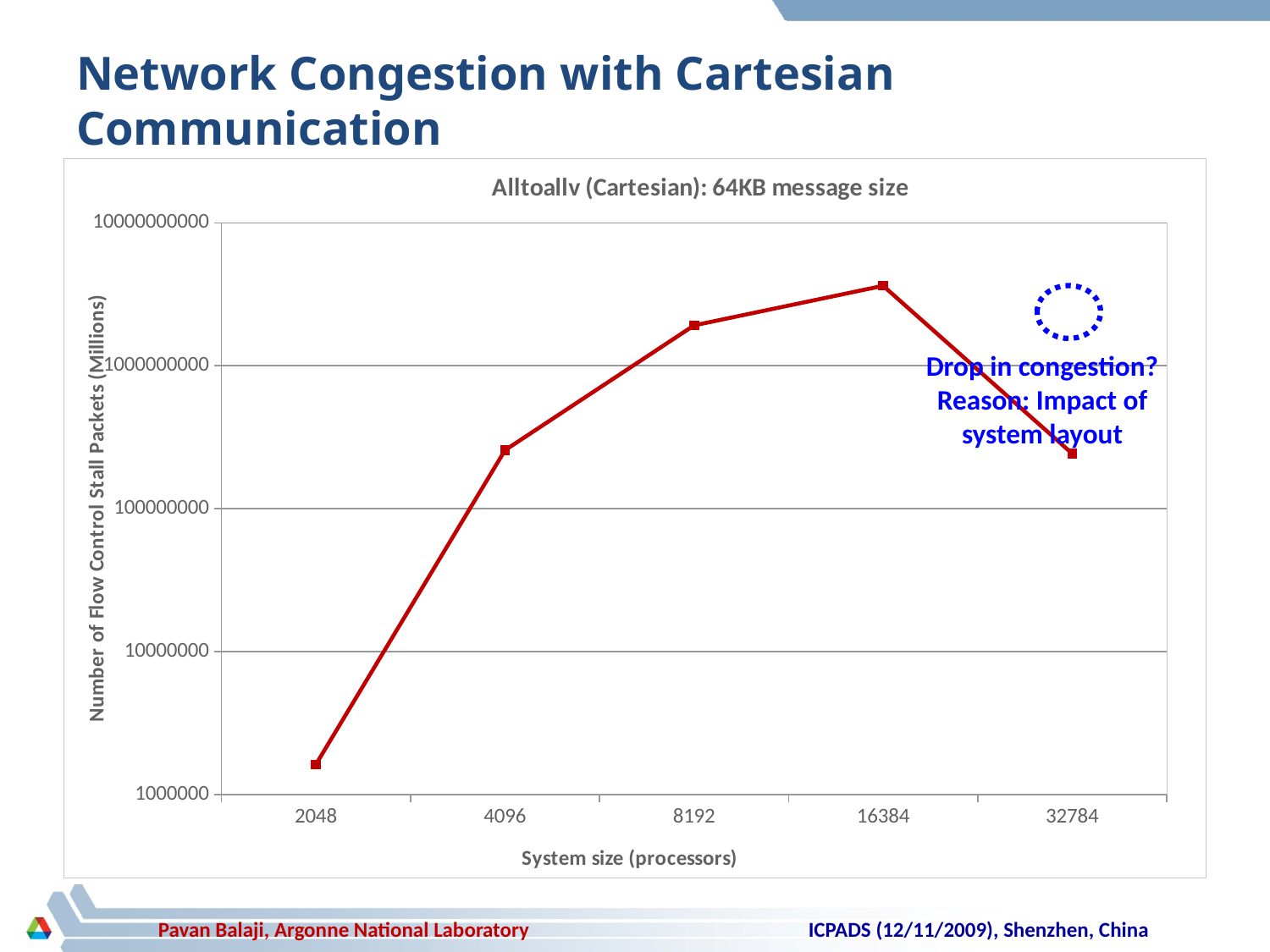
Is the value for 32784 processors greater or less than 1000000000? less At which system size is the number of flow control stall packets lowest? 2048 What is the label of the x axis? System size (processors) What is the title of the chart? Alltoallv (Cartesian): 64KB message size How do the values change as system size increases from 2048 to 32784 processors? rise up to 16384, then fall Is the value for 8192 processors greater or less than 1000000000? greater At which system size is the number of flow control stall packets highest? 16384 What kind of chart is shown on the slide? line chart Which has the larger value, 16384 processors or 32784 processors? 16384 Is the value for 4096 processors greater or less than 100000000? greater How many data points are plotted on the line? 5